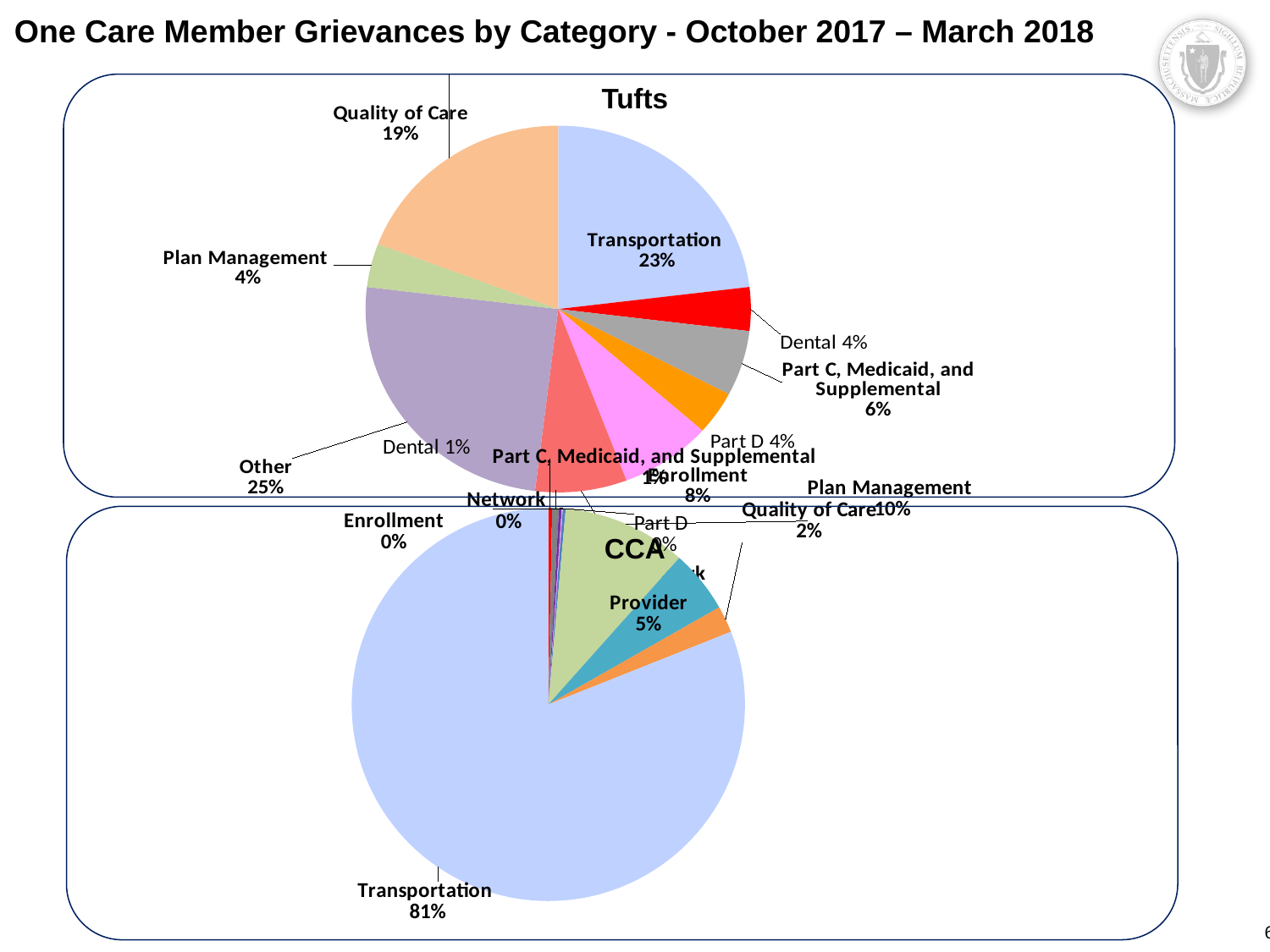
On the Tufts chart, what is the difference in percentage points between Other and Quality of Care? 6 percentage points On the CCA chart, which category has the largest share of grievances? Transportation On the Tufts chart, what percentage of grievances is Quality of Care? 19% On the Tufts chart, which category has the largest share of grievances? Other On the Tufts chart, what percentage of grievances is Transportation? 23% On the Tufts chart, which is larger, Transportation or Quality of Care? Transportation On the Tufts chart, what percentage is Part C, Medicaid, and Supplemental? 6% What type of chart is used on this slide? Pie chart On the Tufts chart, what share of grievances falls under Other? 25% How many charts are shown on the slide? 2 On the CCA chart, what percentage of grievances is Transportation? 81% On the CCA chart, what percentage of grievances is Provider? 5%